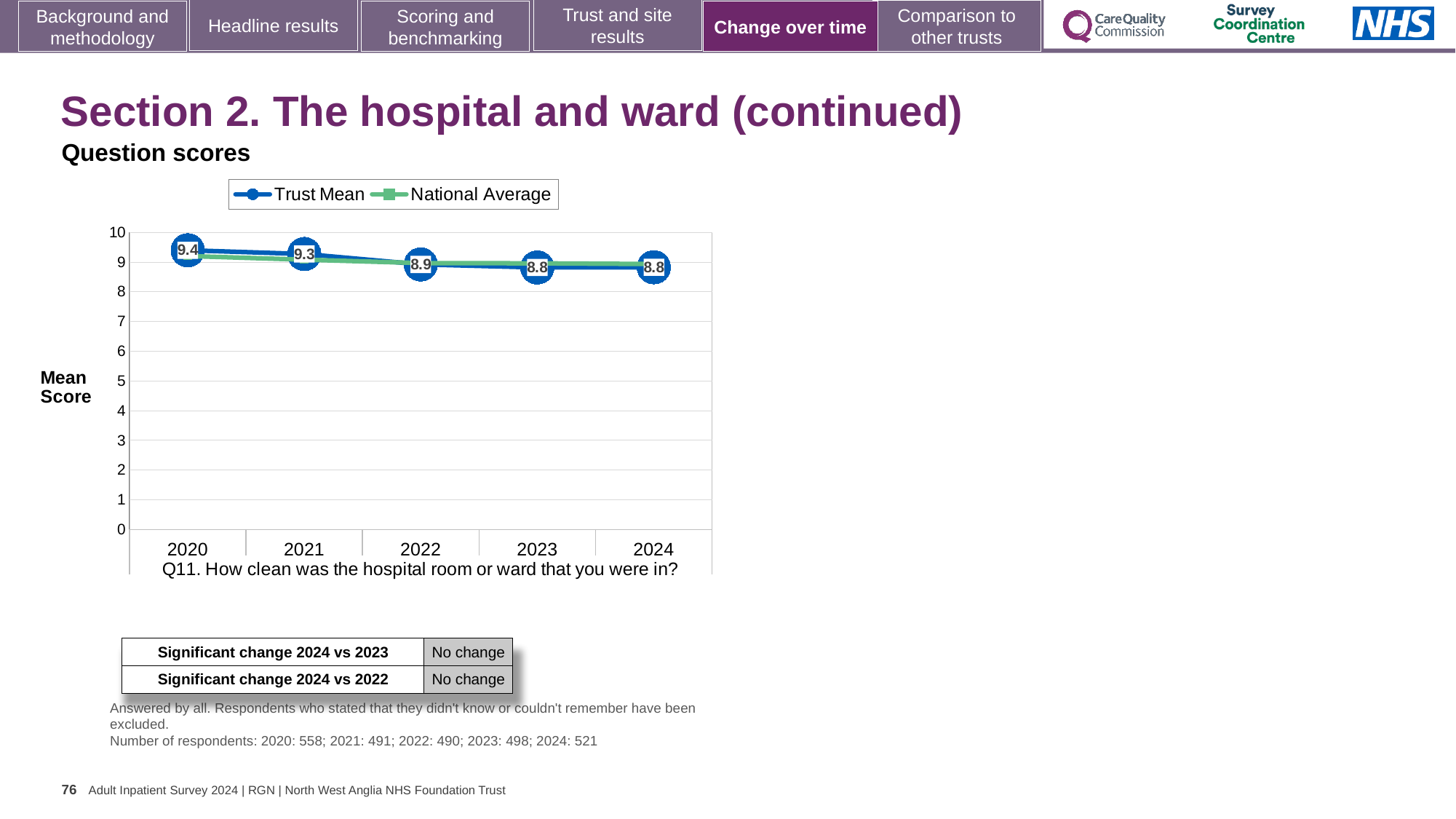
Does the Trust Mean rise or fall from 2020 to 2024? fall What is the Trust Mean value for 2024? 8.8 What is the difference between the Trust Mean in 2020 and in 2024? 0.6 How many years are shown on the x axis? 5 Which is larger, the Trust Mean for 2021 or for 2023? 2021 What is the Trust Mean value for 2022? 8.9 Is the National Average value for 2024 greater or less than 8? greater How many series does the legend list? 2 In which year is the Trust Mean highest? 2020 What is the label on the y axis? Mean Score What kind of chart is shown? line chart What is the Trust Mean value for 2020? 9.4